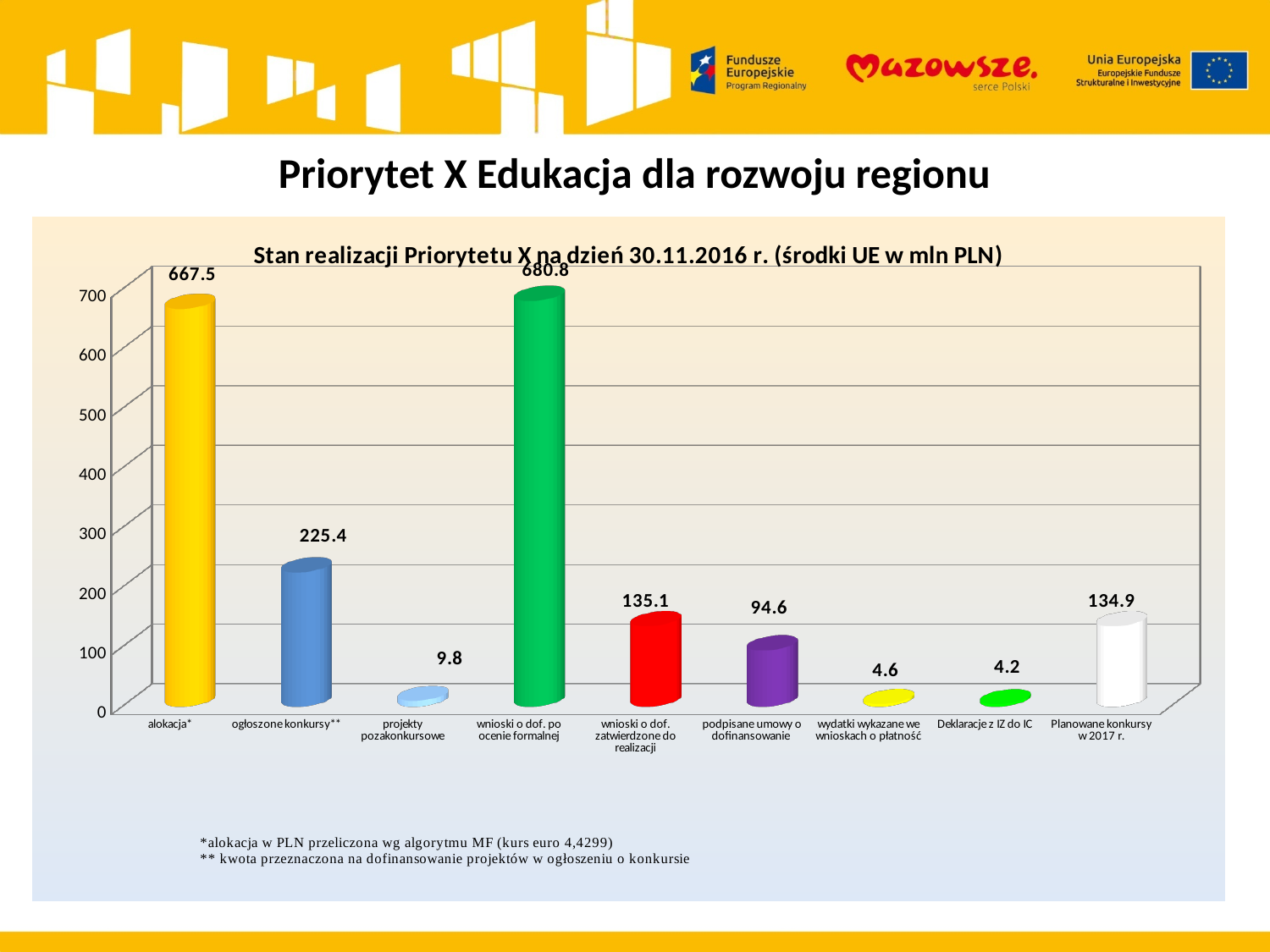
Which is larger, the value for projekty pozakonkursowe or the value for wydatki wykazane we wnioskach o płatność? projekty pozakonkursowe What is the title of the chart? Stan realizacji Priorytetu X na dzień 30.11.2016 r. (środki UE w mln PLN) How many categories are shown on the x axis? 9 What is the value for podpisane umowy o dofinansowanie? 94.6 What is the difference between the values for alokacja* and ogłoszone konkursy**? 442.1 What kind of chart is shown on the slide? bar chart Which category has the lowest value? Deklaracje z IZ do IC What is the value for ogłoszone konkursy**? 225.4 What is the value for Planowane konkursy w 2017 r.? 134.9 What is the difference between the values for ogłoszone konkursy** and wnioski o dof. zatwierdzone do realizacji? 90.3 Which category has the highest value? wnioski o dof. po ocenie formalnej What is the value for alokacja*? 667.5